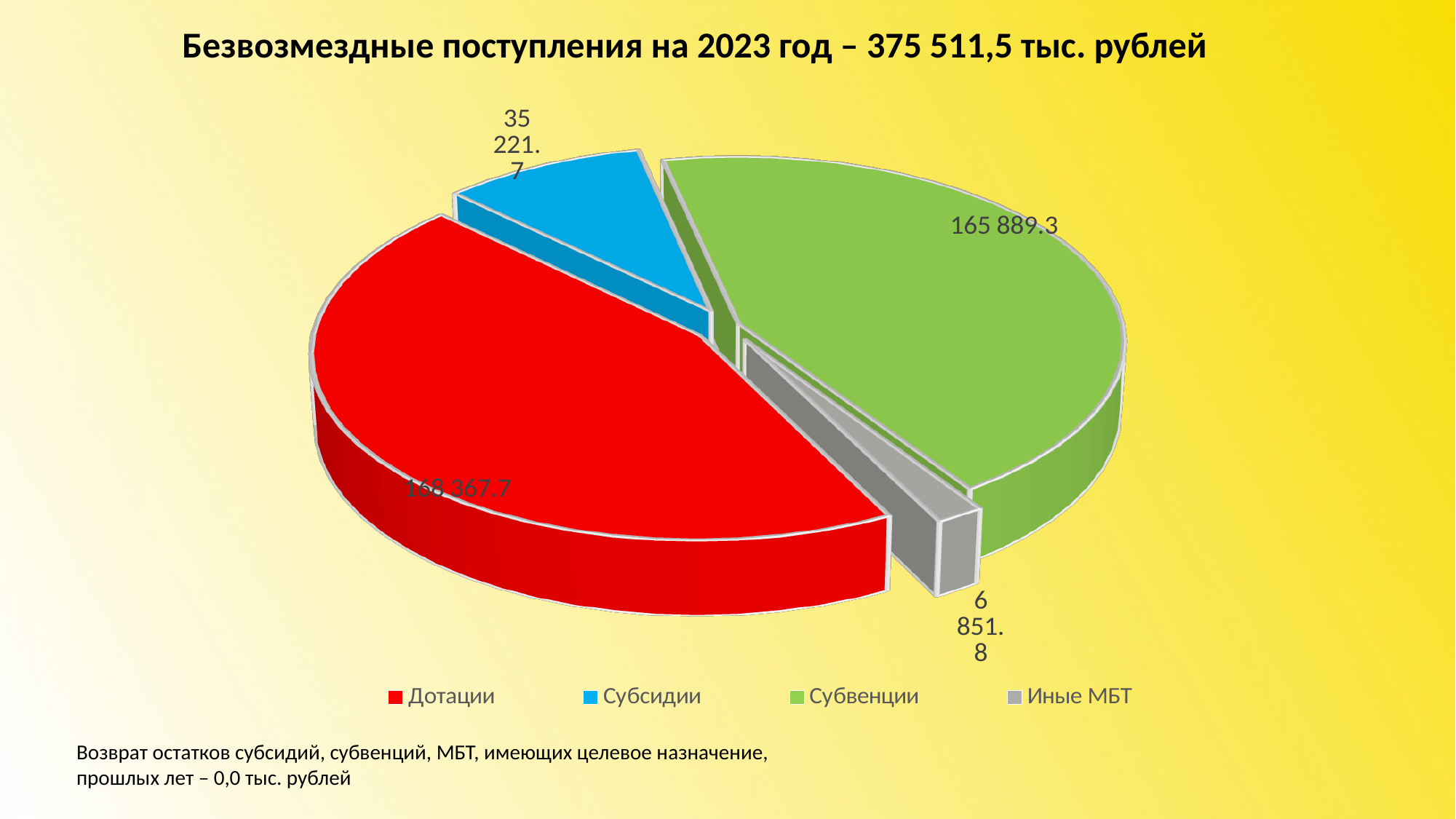
What is the value for Субвенции? 165 889.3 What is the value for Иные МБТ? 6 851.8 What is the value for Дотации? 168 367.7 What type of chart is shown on the slide? Pie chart What is the difference between the values for Субсидии and Иные МБТ? 28 369.9 Which category has the largest value? Дотации Which colour represents Субвенции in the chart? Green How many slices does the pie chart have? 4 Which is larger, Субсидии or Иные МБТ? Субсидии What is the difference between the values for Дотации and Субвенции? 2 478.4 What is the value for Субсидии? 35 221.7 Which category has the smallest value? Иные МБТ